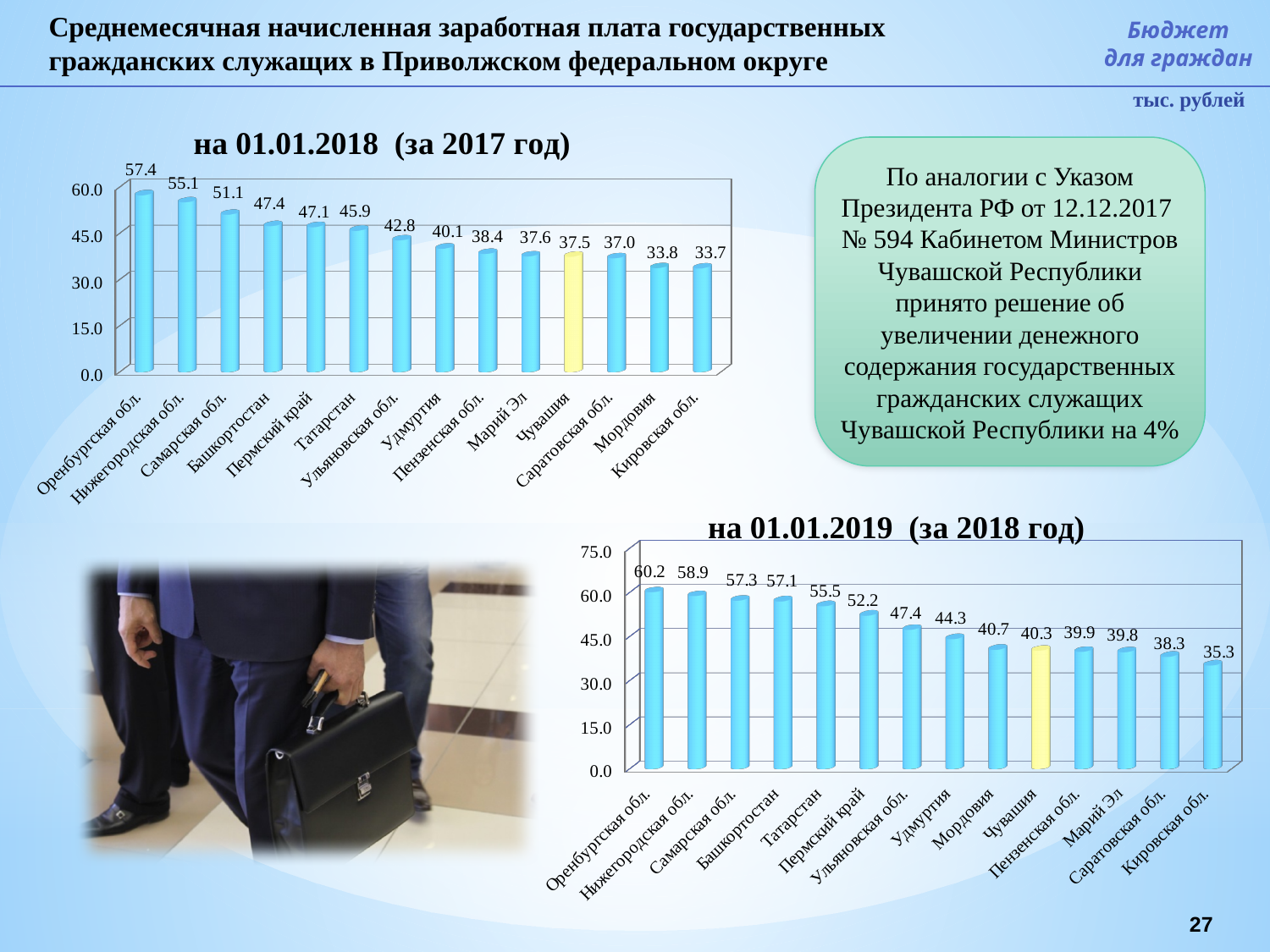
In the chart titled "на 01.01.2019 (за 2018 год)", what is the value for Татарстан? 55.5 In the chart titled "на 01.01.2019 (за 2018 год)", is the value for Пермский край greater or less than 45.0? greater How many categories are shown in the chart titled "на 01.01.2018 (за 2017 год)"? 14 In the chart titled "на 01.01.2018 (за 2017 год)", do the values rise or fall from left to right along the x axis? fall In the chart titled "на 01.01.2018 (за 2017 год)", which is larger: the value for Самарская обл. or the value for Удмуртия? Самарская обл. In the chart titled "на 01.01.2018 (за 2017 год)", what is the value for Чувашия? 37.5 In the chart titled "на 01.01.2018 (за 2017 год)", which bar is coloured yellow instead of blue? Чувашия What kind of chart is the chart titled "на 01.01.2019 (за 2018 год)"? bar chart In the chart titled "на 01.01.2019 (за 2018 год)", which category has the lowest value? Кировская обл. In the chart titled "на 01.01.2019 (за 2018 год)", what is the difference between the values for Оренбургская обл. and Кировская обл.? 24.9 In the chart titled "на 01.01.2018 (за 2017 год)", which category has the highest value? Оренбургская обл. In the chart titled "на 01.01.2019 (за 2018 год)", what is the difference between the values for Чувашия and Мордовия? 0.4